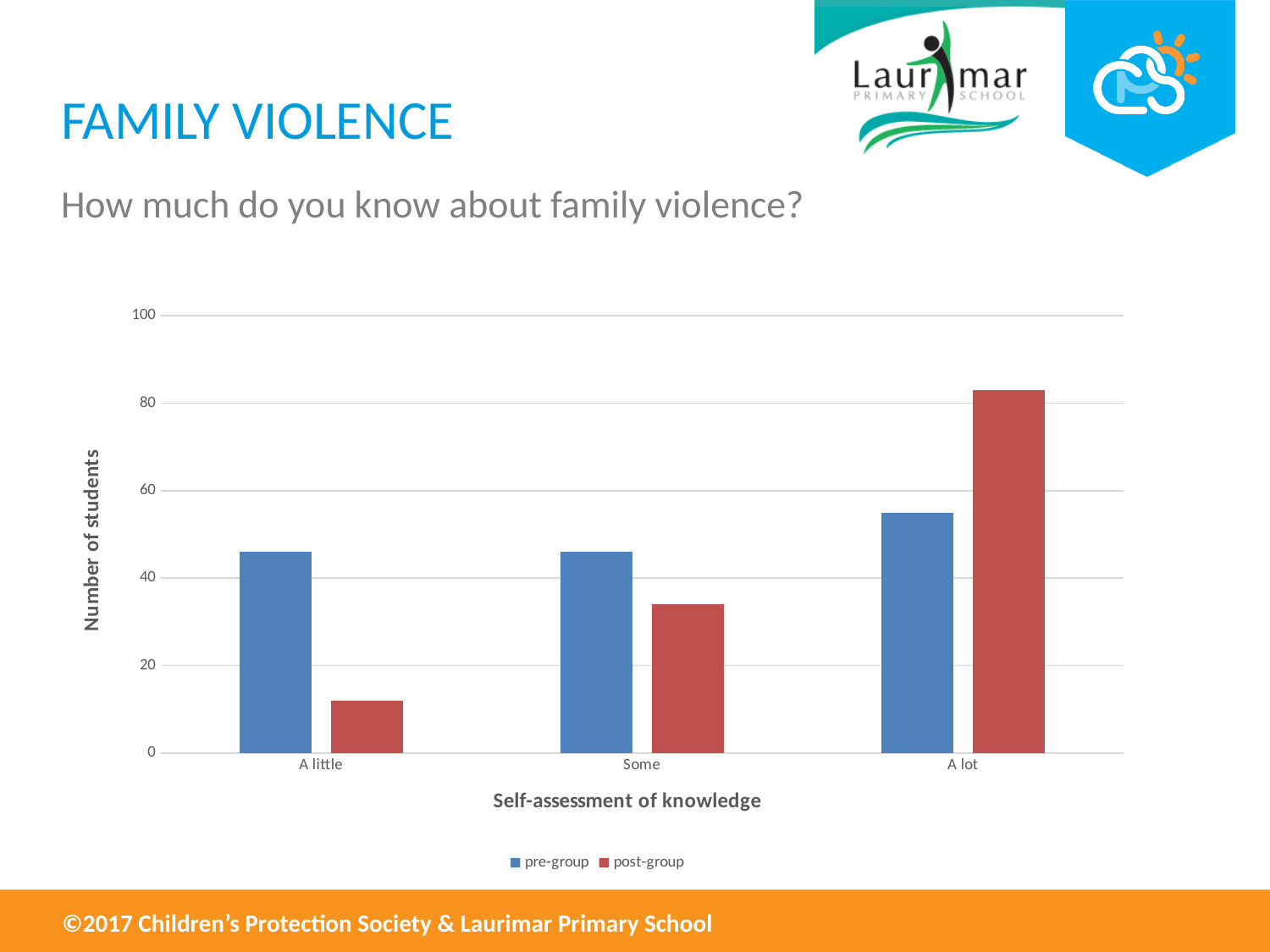
Is the post-group value for A lot greater or less than 60? greater For the A little category, which is larger: the pre-group or the post-group value? pre-group How many categories are shown on the x axis? 3 For the A lot category, which is larger: the pre-group or the post-group value? post-group Is the post-group value for A little greater or less than 20? less Is the pre-group value for A lot greater or less than 60? less Do the post-group values rise or fall from A little to A lot along the x axis? rise How many series does the legend list? 2 Which category has the highest pre-group value? A lot Which category has the highest post-group value? A lot What kind of chart is shown on the slide? bar chart Which category has the lowest post-group value? A little